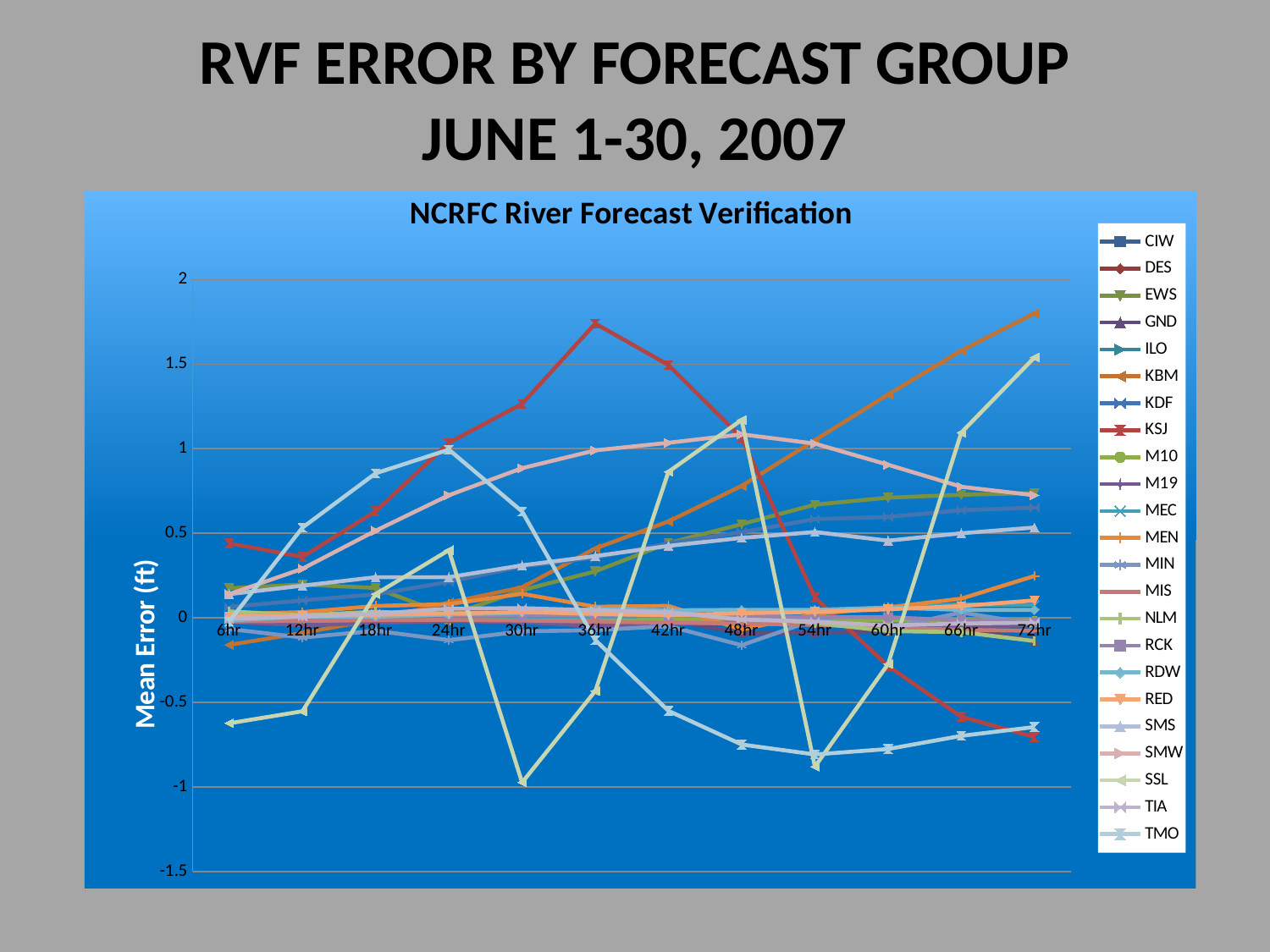
How many forecast lead-time categories are shown on the x axis? 12 What is the title of the chart? NCRFC River Forecast Verification Does the KSJ line rise or fall between 36hr and 72hr? fall Which is larger for KSJ: the value at 36hr or the value at 54hr? 36hr What is the label on the y axis? Mean Error (ft) Is the value for KSJ at 36hr greater or less than 1.5? greater At which lead time does the KSJ line reach its highest value? 36hr What kind of chart is shown on the slide? line chart Is the value for KSJ at 72hr greater or less than -0.5? less Is the value for KSJ at 42hr greater or less than 1? greater Does the KSJ line rise or fall between 12hr and 36hr? rise How many series does the legend list? 23